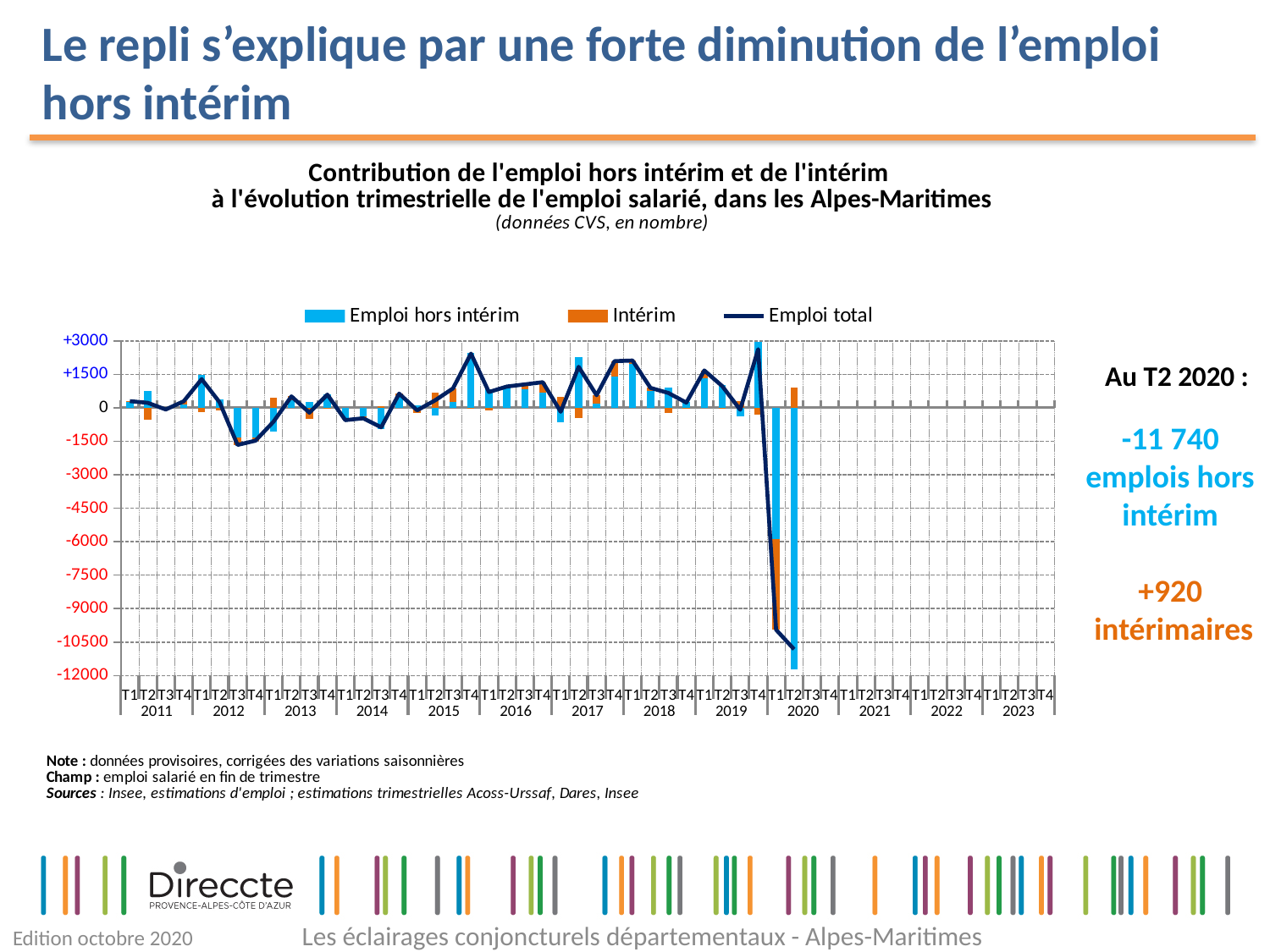
How many series does the chart legend list? 3 What colour represents the Intérim series in the chart? Orange Is the value of Emploi total at T2 2020 greater or less than -9000? less In which quarter is the Emploi hors intérim bar the lowest? T2 2020 How many years are labelled on the x axis of the chart? 13 What is the value for Emploi hors intérim at T2 2020? -11 740 What is the difference between the Intérim value (+920) and the Emploi hors intérim value (-11 740) at T2 2020? 12 660 Is the value of Emploi hors intérim at T4 2019 greater or less than +1500? greater At T2 2020, which is larger, the value for Emploi hors intérim or the value for Intérim? Intérim What kind of chart is shown on the slide? Combined bar and line chart What is the value for Intérim at T2 2020? +920 Does the Emploi total line rise or fall between T4 2019 and T2 2020? fall